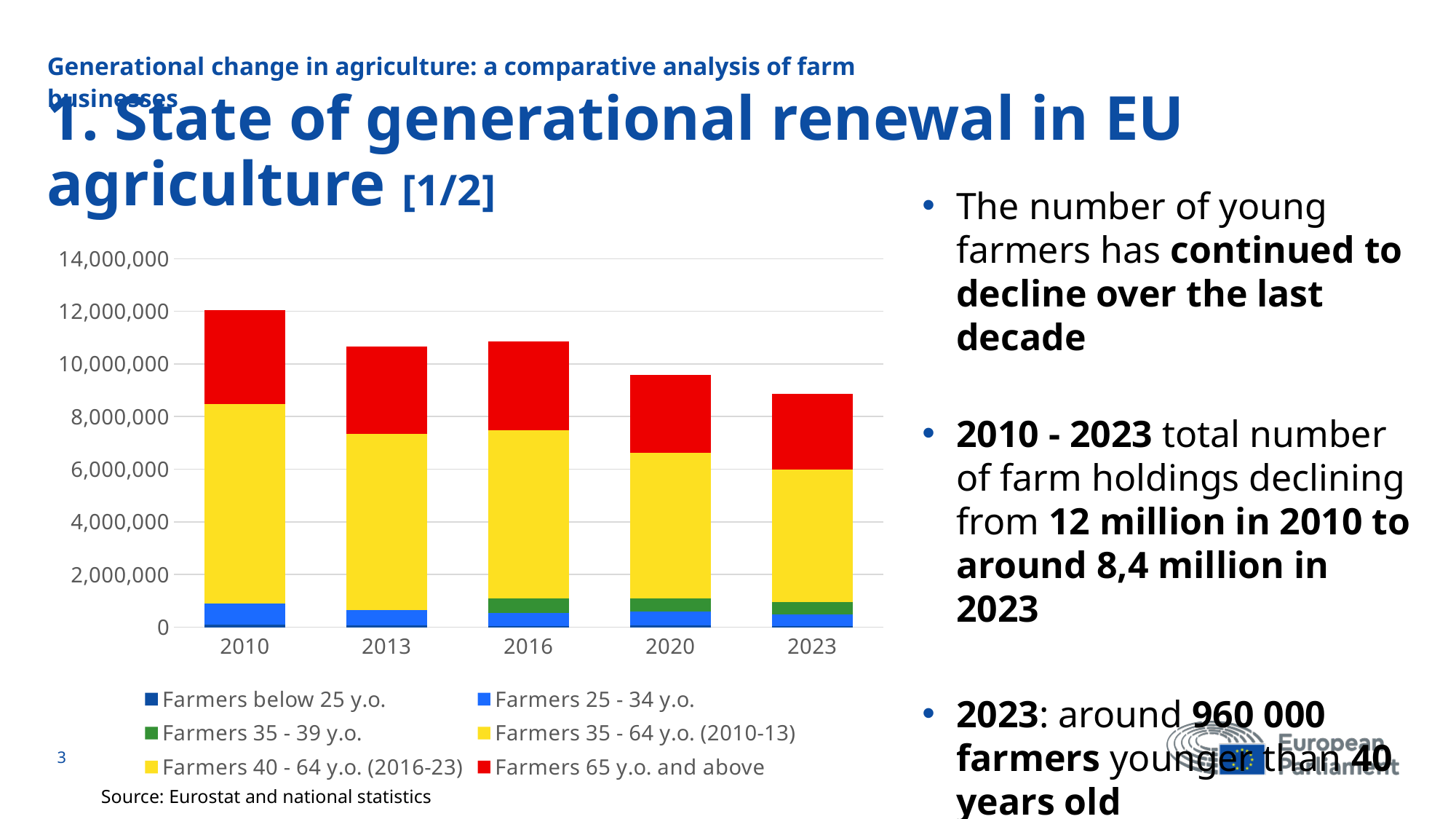
Which year has the tallest stacked bar in the chart? 2010 How many years are shown on the x axis of the chart? 5 Which colour represents 'Farmers 65 y.o. and above' in the chart's legend? Red What kind of chart is shown on the slide? Stacked bar chart Is the total bar height for 2023 greater or less than 10,000,000? less Is the total bar height for 2016 greater or less than 10,000,000? greater How many series does the chart's legend list? 6 What is the highest value shown on the chart's y axis? 14,000,000 Is the total bar height for 2010 greater or less than 10,000,000? greater Which year has a taller stacked bar, 2010 or 2023? 2010 Which year has the shortest stacked bar in the chart? 2023